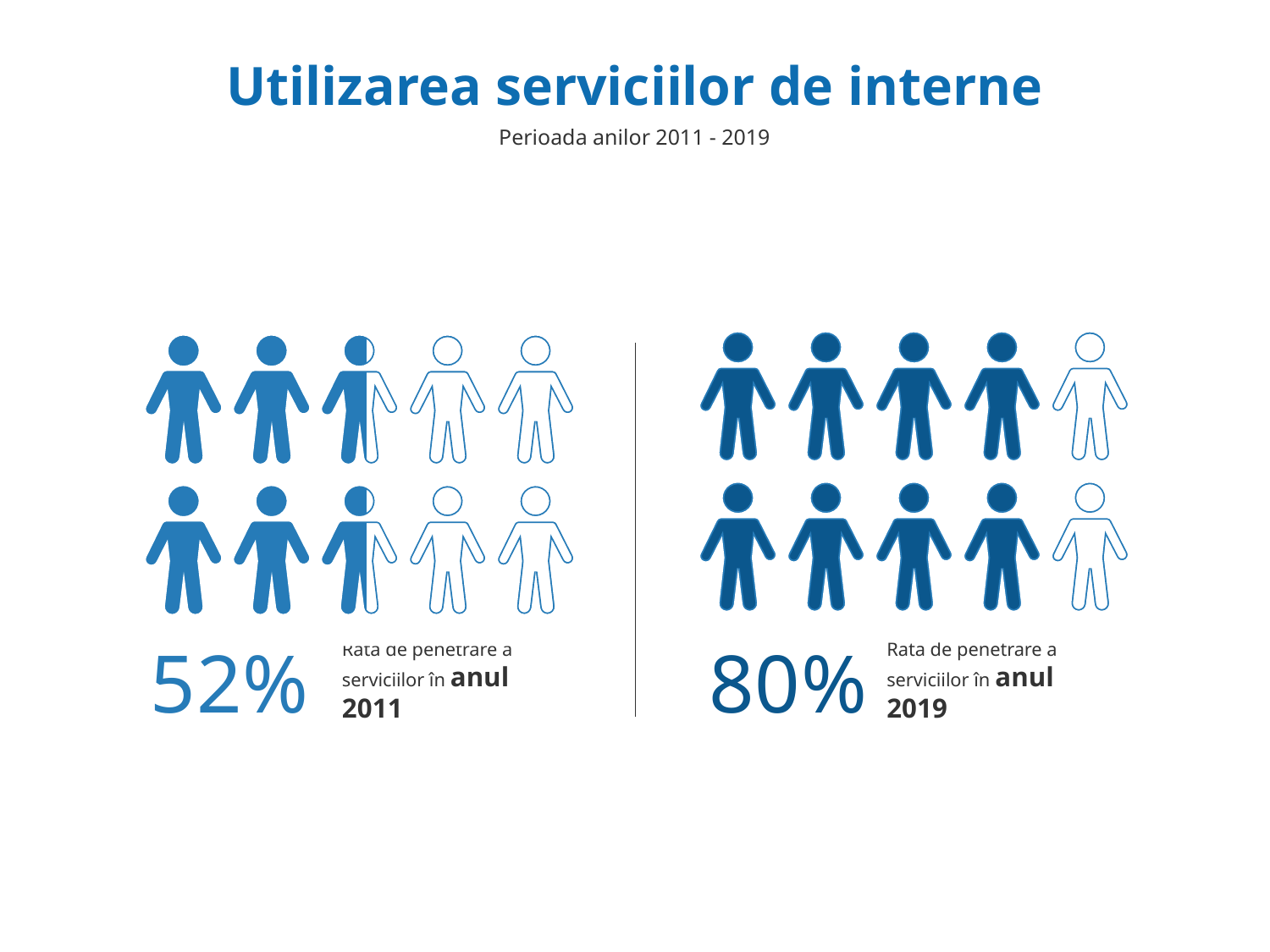
Did the penetration rate rise or fall between 2011 and 2019? rise How many person icons are shown in the 2019 pictogram? 10 What is the service penetration rate shown for the year 2019? 80% What period does the subtitle say the data covers? 2011 - 2019 By how many percentage points did the penetration rate increase from 2011 to 2019? 28 percentage points Which year shows the lowest penetration rate on the slide? 2011 Which year has the higher penetration rate, 2011 or 2019? 2019 What kind of chart is used to show the penetration rates on this slide? pictogram (people icon) chart How many years (data points) are compared on the slide? 2 What is the title of the slide? Utilizarea serviciilor de interne How many person icons are shown in the 2011 pictogram? 10 What is the service penetration rate shown for the year 2011? 52%